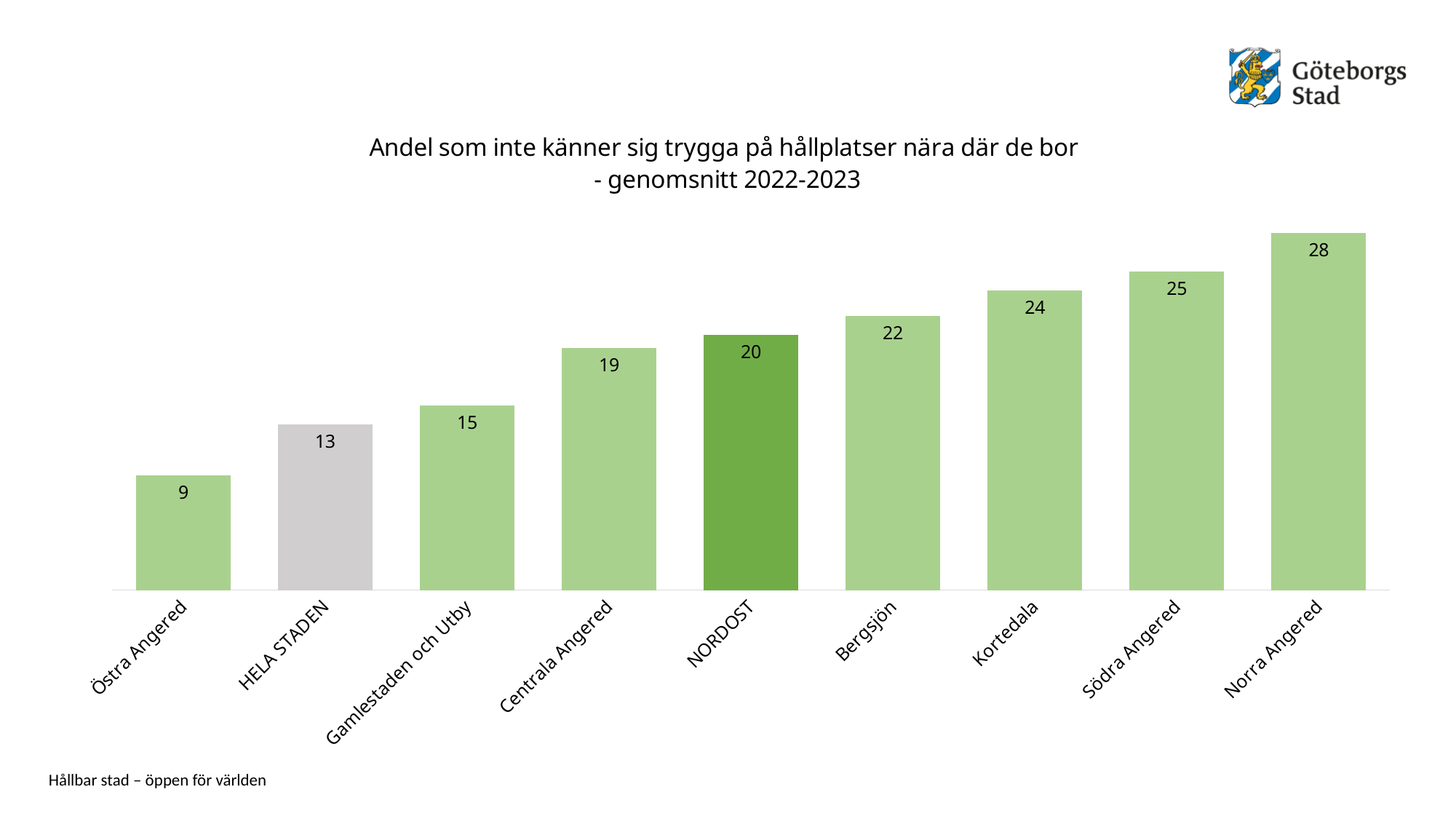
Which bar is coloured grey instead of green? HELA STADEN How many categories are shown on the x axis? 9 Which category has the lowest value? Östra Angered What is the value for NORDOST? 20 What is the difference between the values for Norra Angered and Östra Angered? 19 What is the difference between the values for Bergsjön and Centrala Angered? 3 What kind of chart is shown on the slide? Bar chart Do the values rise or fall from left to right along the x axis? Rise Which category has the highest value? Norra Angered What is the value for Gamlestaden och Utby? 15 What is the value for HELA STADEN? 13 Which is larger, the value for Kortedala or the value for Södra Angered? Södra Angered